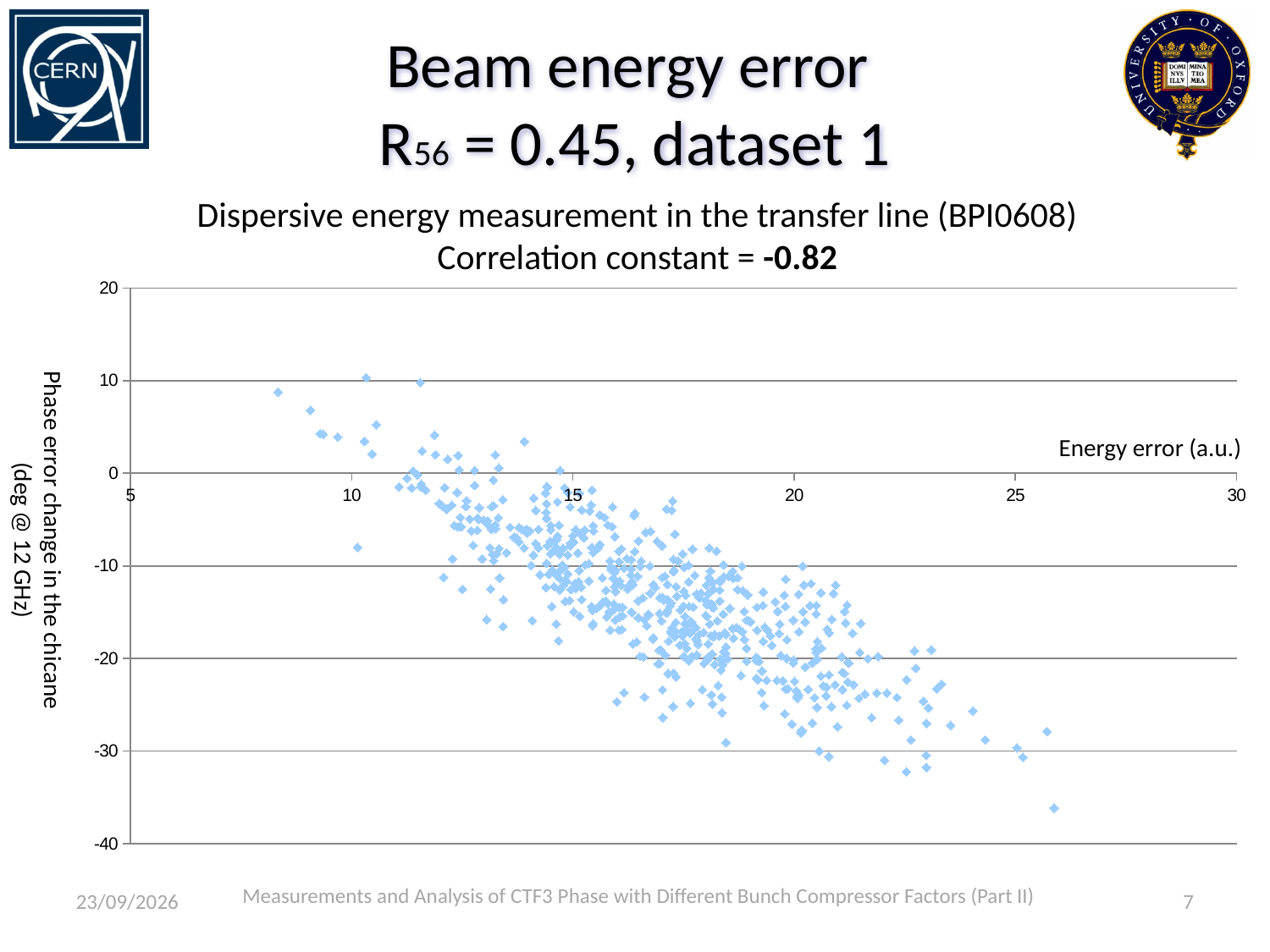
What is the label of the x axis of the chart? Energy error (a.u.) What kind of chart is shown on the slide? scatter plot What is the label of the y axis of the chart? Phase error change in the chicane (deg @ 12 GHz) As the energy error increases along the x axis, does the phase error change generally rise or fall? fall What is the highest value shown on the x axis of the chart? 30 What is the lowest value shown on the y axis of the chart? -40 Is the correlation between energy error and phase error change positive or negative? negative What is the correlation constant stated above the chart? -0.82